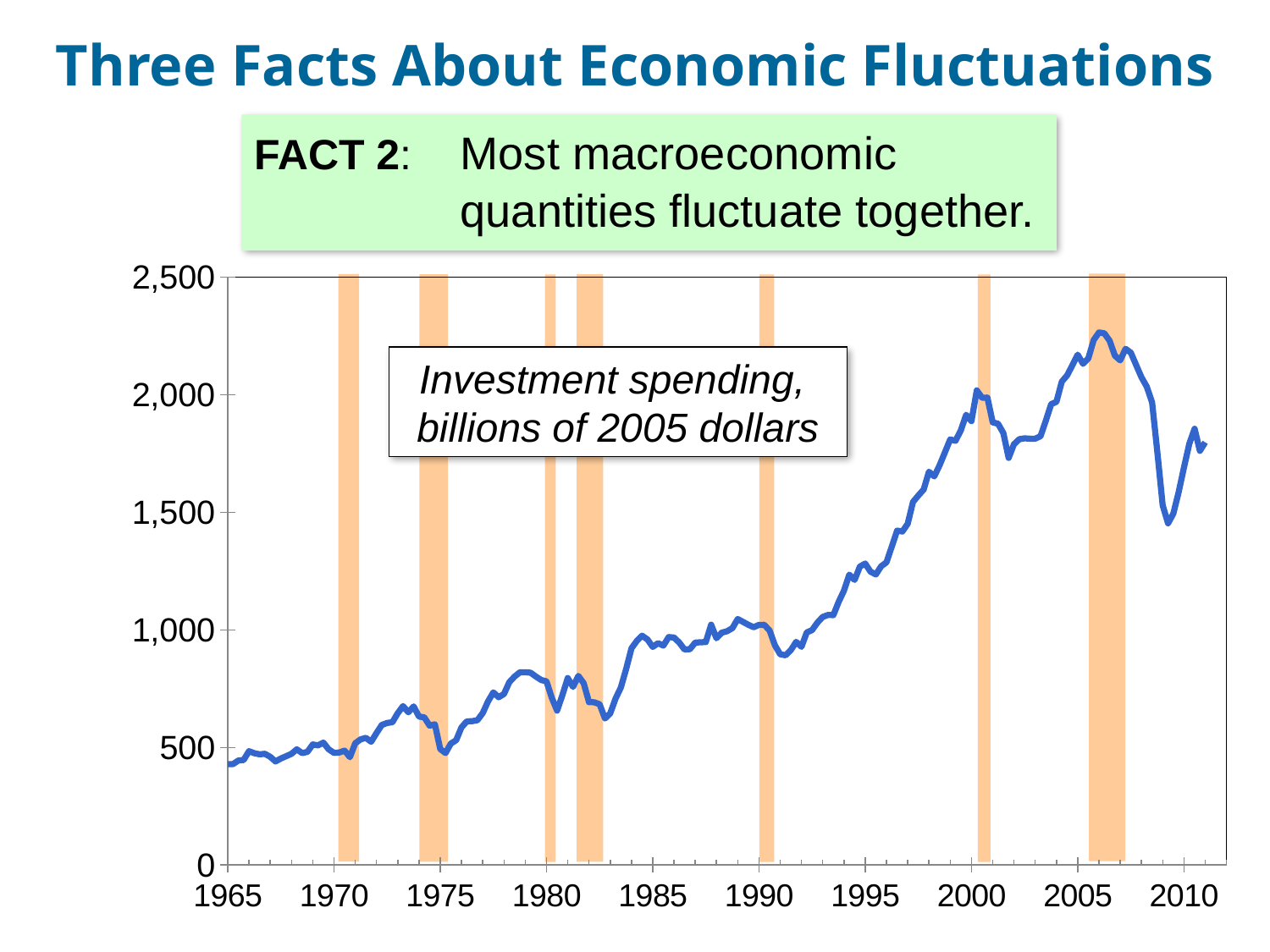
Is the lowest value of investment spending in 2009 greater or less than 1,000? greater What kind of chart is shown on the slide? line chart Is the value of investment spending in 2000 greater or less than 1,500? greater Is the peak value of investment spending around 2006 greater or less than 2,000? greater Overall, does investment spending rise or fall from 1965 to 2010? rise Around which year does investment spending reach its highest value on the chart? 2006 What quantity does the chart plot, according to the label on the chart? Investment spending, billions of 2005 dollars Which year has the larger value of investment spending, 1970 or 2005? 2005 What is the first year shown on the x axis of the chart? 1965